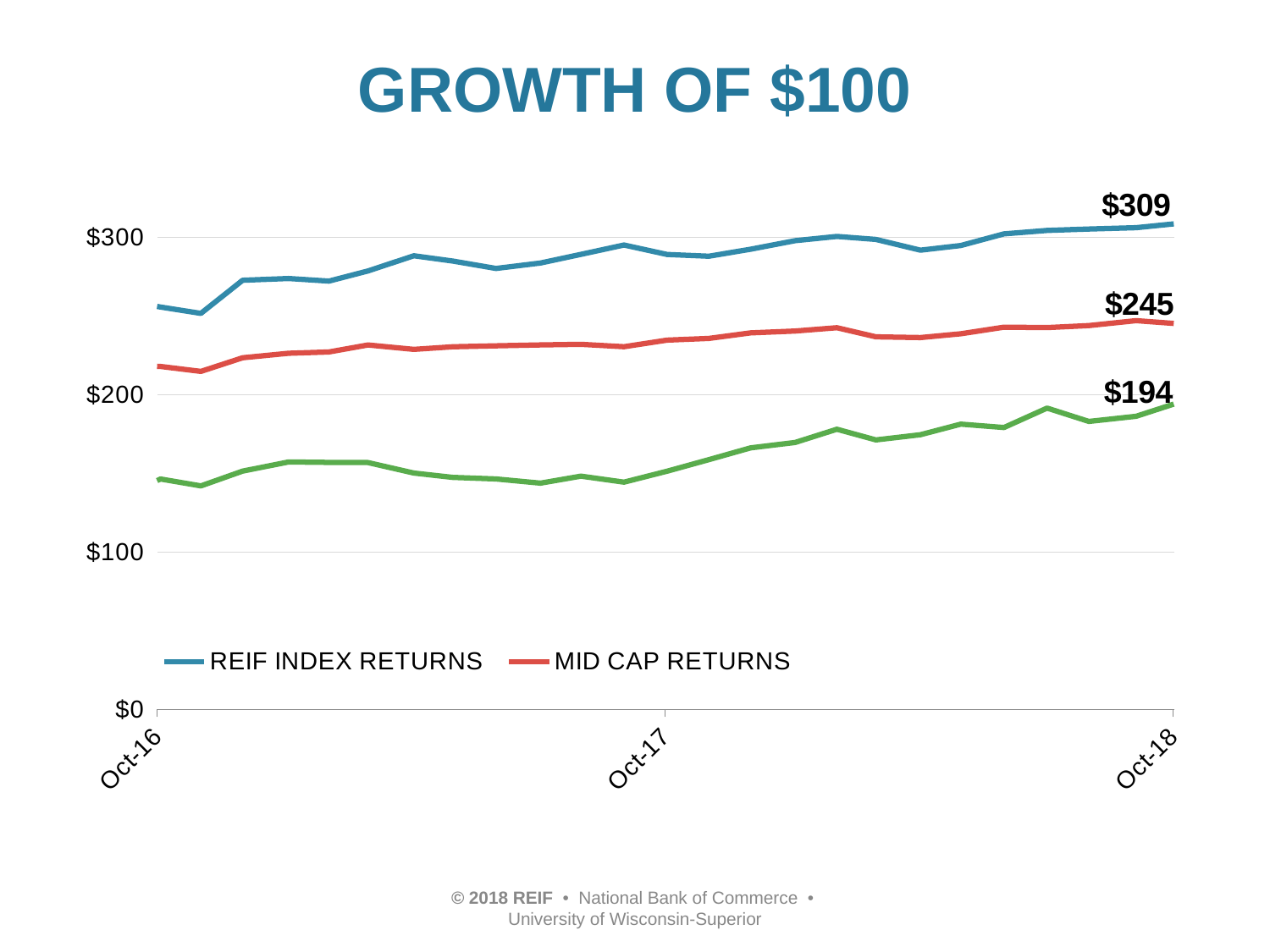
How many series does the legend list? 2 What colour is the MID CAP RETURNS line? red What kind of chart is shown on the slide? line chart Does the REIF INDEX RETURNS line generally rise or fall from Oct-16 to Oct-18? rise Which series has the higher value at Oct-18, REIF INDEX RETURNS or MID CAP RETURNS? REIF INDEX RETURNS What is the value of MID CAP RETURNS at Oct-18? $245 What is the value of REIF INDEX RETURNS at Oct-18? $309 Is the value for MID CAP RETURNS at Oct-16 greater or less than $200? greater Is the value for REIF INDEX RETURNS at Oct-16 greater or less than $300? less Which line has the highest value at Oct-18? REIF INDEX RETURNS What is the title of the chart? GROWTH OF $100 What is the difference between REIF INDEX RETURNS and MID CAP RETURNS at Oct-18? $64